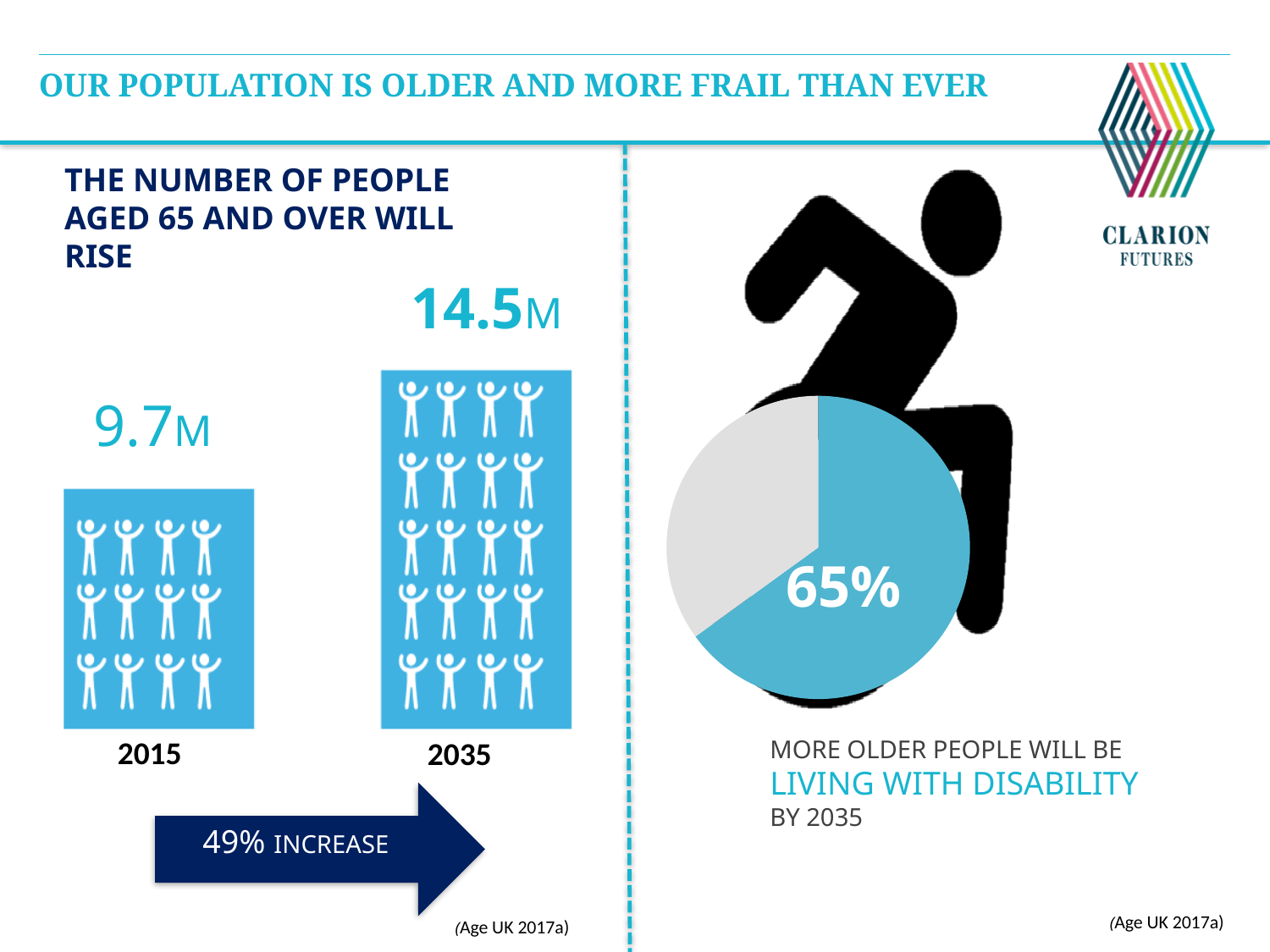
What kind of chart is on the right side of the slide? pie chart In the left chart, what is the difference between the 2035 and 2015 values? 4.8M How many years (categories) are shown in the left chart? 2 In the left chart, what percentage increase is shown between 2015 and 2035? 49% increase In the left chart, do the values rise or fall from 2015 to 2035? rise In the left chart, which year has the lower value? 2015 In the left chart, which year has the higher value? 2035 In the pie chart on the right, what share is shown for the blue slice? 65% In the left chart, what is the number of people aged 65 and over projected for 2035? 14.5M In the left chart, is the value for 2035 larger or smaller than the value for 2015? larger In the left chart, what is the number of people aged 65 and over in 2015? 9.7M What kind of chart is the left chart showing people aged 65 and over? bar chart